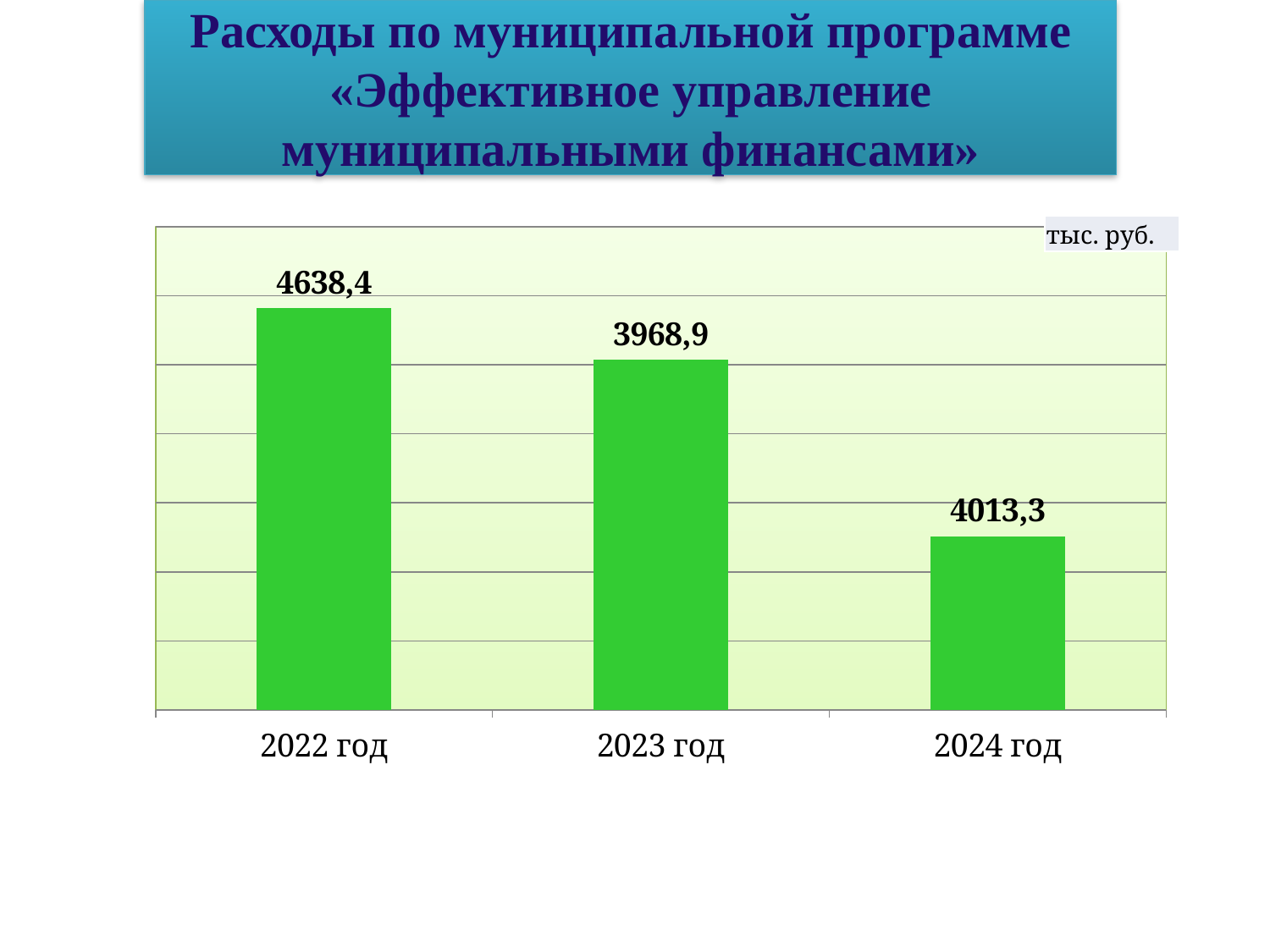
How many years are shown on the chart? 3 What is the value for 2024 год? 4013,3 What is the difference between the values for 2022 год and 2024 год? 625,1 What is the value for 2022 год? 4638,4 What is the value for 2023 год? 3968,9 Which is larger, the value for 2022 год or the value for 2023 год? 2022 год Which year has the highest value? 2022 год What colour are the bars on the chart? green Which is larger, the value for 2022 год or the value for 2024 год? 2022 год What unit is indicated in the top right corner of the chart? тыс. руб. What is the difference between the values for 2022 год and 2023 год? 669,5 What kind of chart is shown on the slide? bar chart